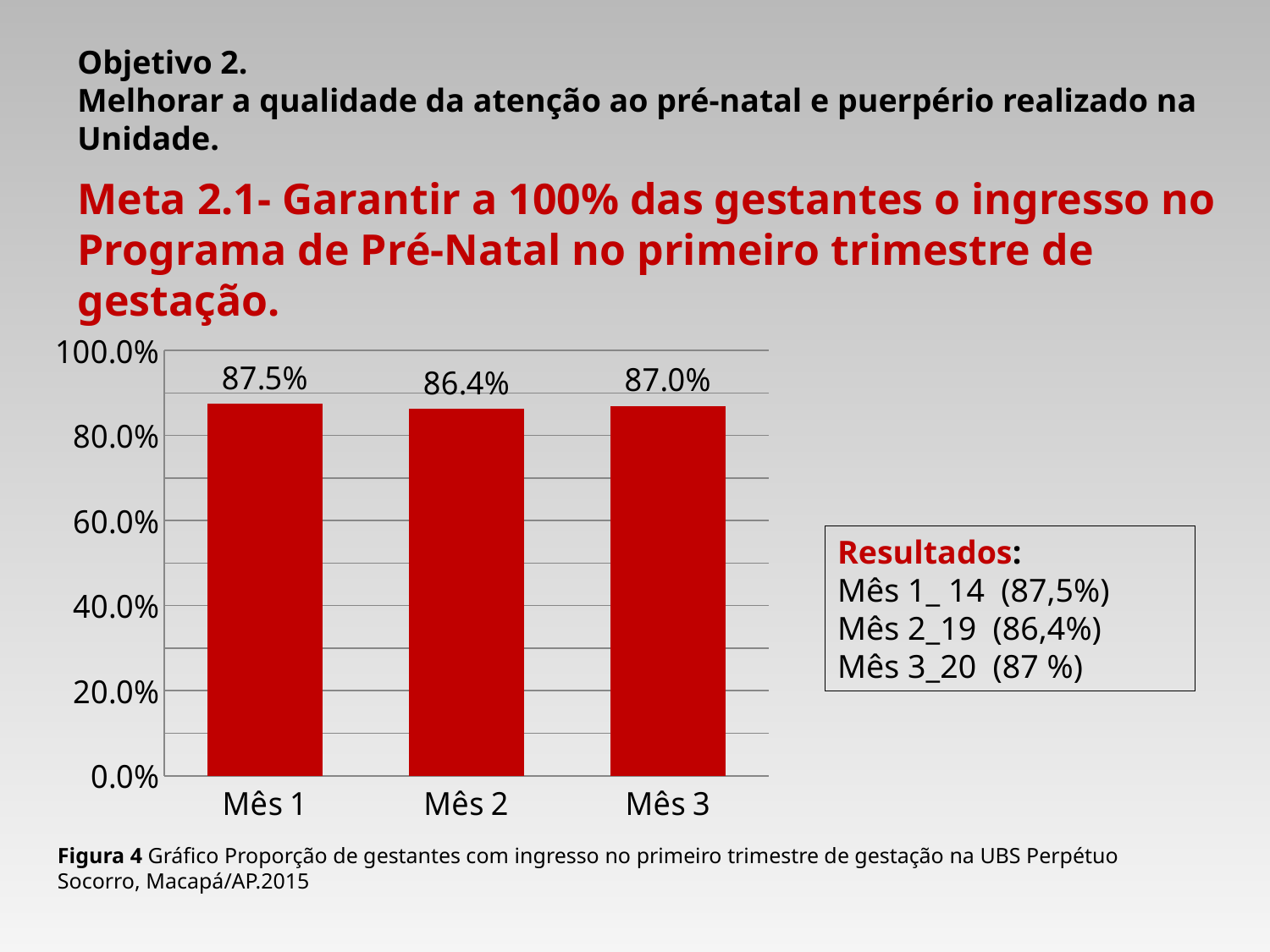
Does the value rise or fall from Mês 1 to Mês 2? fall What is the value for Mês 1? 87.5% What is the value for Mês 2? 86.4% What colour are the bars in the chart? red Is the value for Mês 2 greater or less than 80.0%? greater How many months are shown on the x axis? 3 Which month has the lowest value? Mês 2 What kind of chart is shown on the slide? bar chart What is the value for Mês 3? 87.0% What is the difference between the values for Mês 1 and Mês 2? 1.1 percentage points Which is larger, the value for Mês 3 or the value for Mês 2? Mês 3 Which month has the highest value? Mês 1